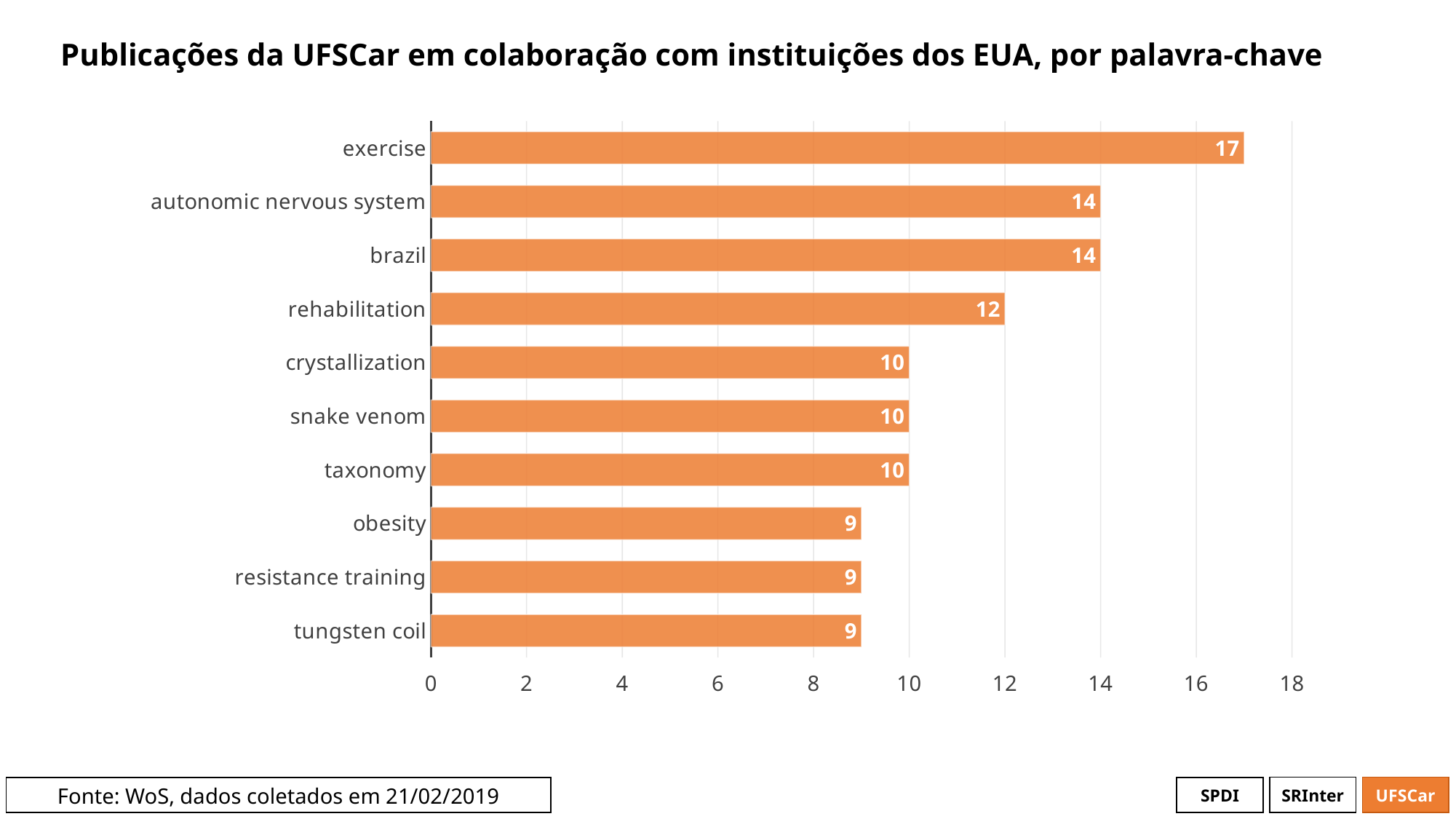
What is the value for snake venom? 10 Is the value for exercise greater or less than 16? greater What is the value for exercise? 17 Which keyword has the highest value? exercise What is the difference between the values for exercise and brazil? 3 What kind of chart is shown on the slide? bar chart What is the title of the chart? Publicações da UFSCar em colaboração com instituições dos EUA, por palavra-chave How many keywords are shown in the chart? 10 What is the difference between the values for rehabilitation and obesity? 3 Which is larger, the value for autonomic nervous system or the value for crystallization? autonomic nervous system What is the value for rehabilitation? 12 What is the value for tungsten coil? 9